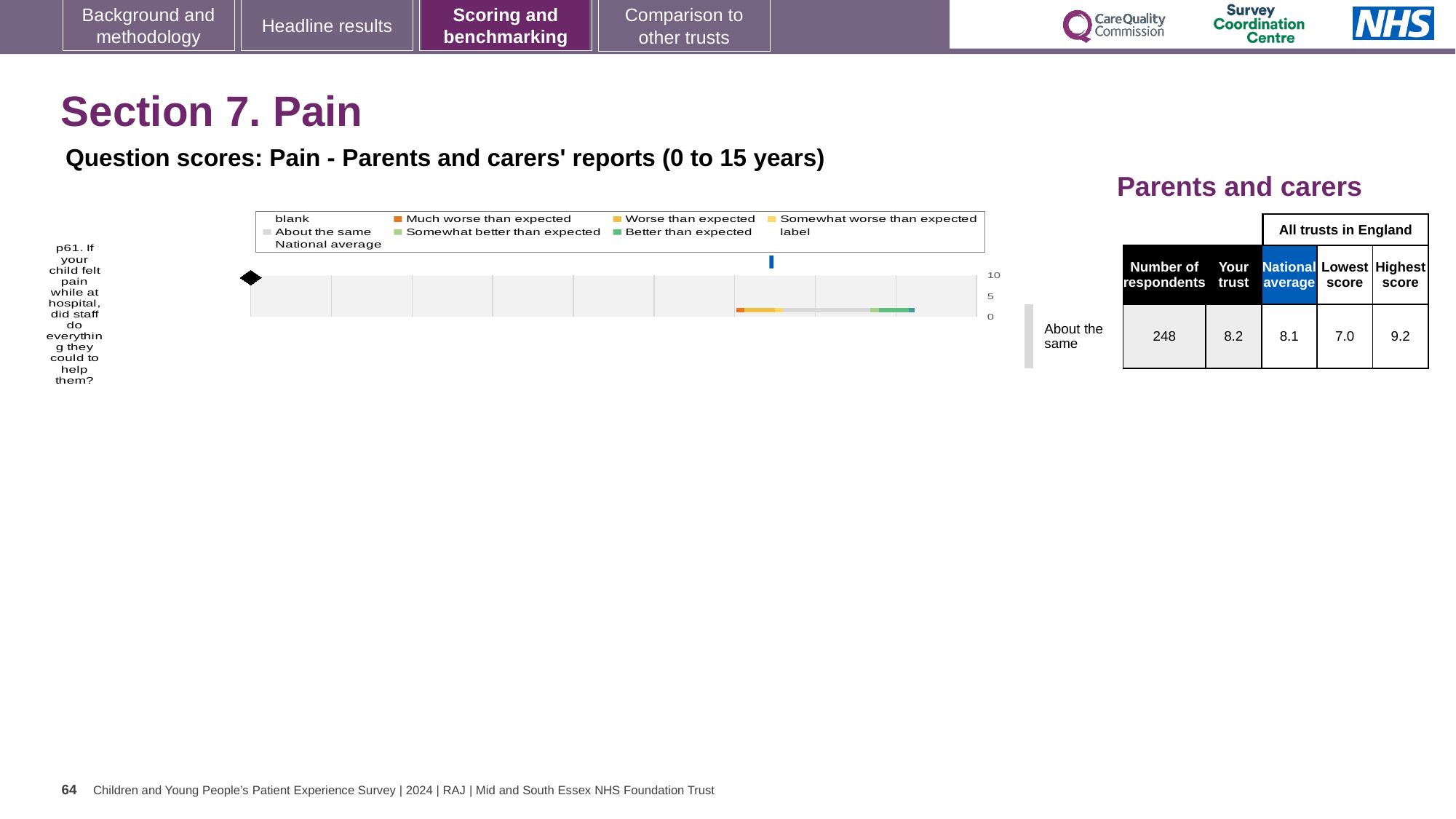
Which benchmark category is shown for question p61 next to the chart? About the same What is the difference between the 'Your trust' score and the national average for question p61? 0.1 In the table beside the chart, what is the 'Your trust' score for question p61? 8.2 What colour does the legend use for 'Much worse than expected'? orange Which is larger for question p61: the 'Your trust' score or the national average? Your trust In the table beside the chart, what is the lowest score among all trusts in England for question p61? 7.0 What is the difference between the highest score and the lowest score for question p61 in the table beside the chart? 2.2 How many survey questions are plotted in the chart? 1 What kind of chart is shown on the slide for question p61? bar chart In the table beside the chart, what is the national average score for question p61? 8.1 How many respondents answered question p61, according to the table beside the chart? 248 In the table beside the chart, what is the highest score among all trusts in England for question p61? 9.2